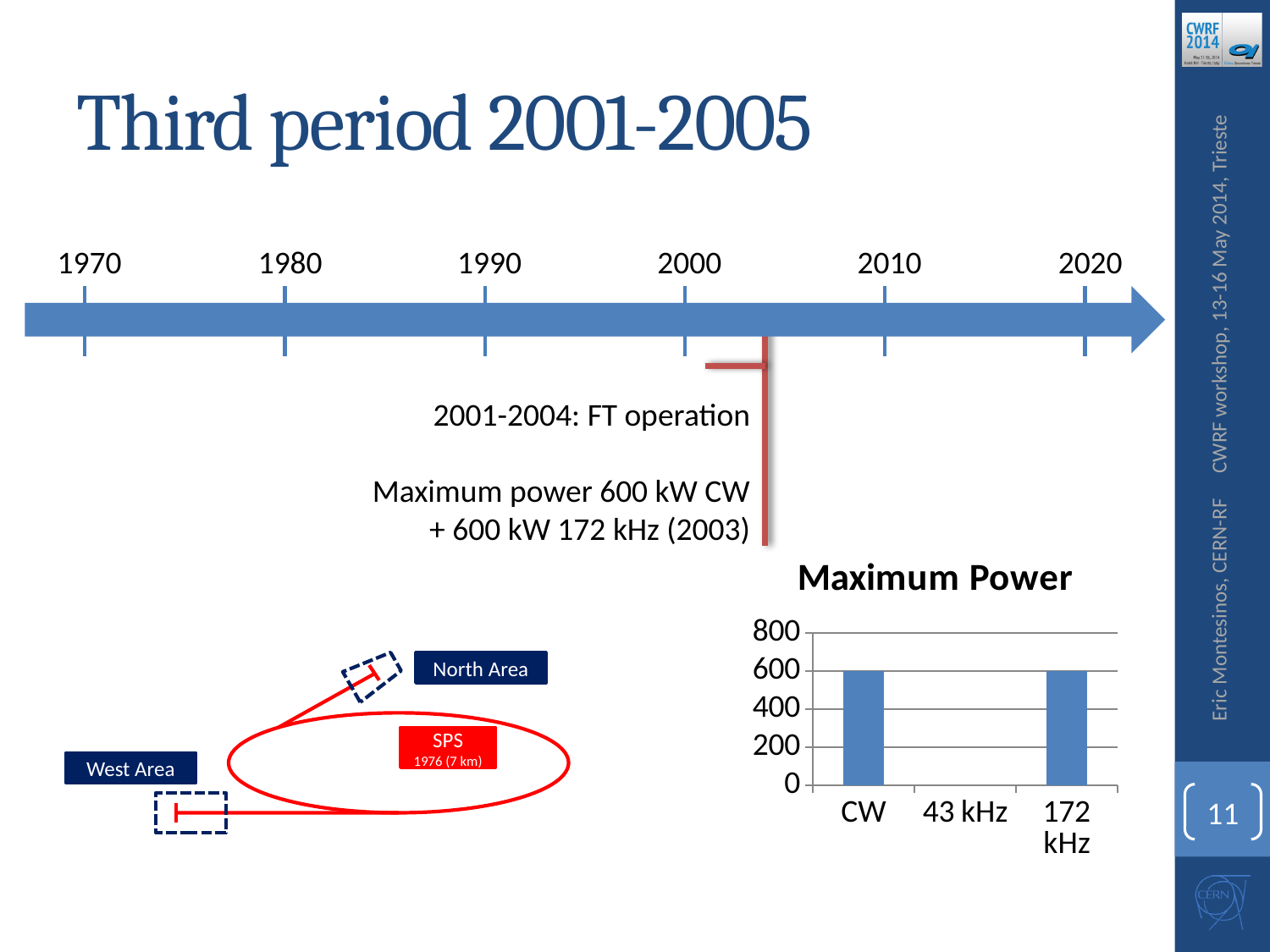
In the Maximum Power chart, what is the difference between the values for CW and 172 kHz? 0 In the Maximum Power chart, what is the value for CW? 600 In the Maximum Power chart, is the value for 43 kHz greater or less than 200? less What is the highest tick value shown on the y axis of the Maximum Power chart? 800 In the Maximum Power chart, which category has the lowest value? 43 kHz In the Maximum Power chart, is the value for CW greater or less than 400? greater How many categories are shown on the x axis of the Maximum Power chart? 3 In the Maximum Power chart, is the value for 172 kHz greater or less than 800? less What is the title of the chart on the slide? Maximum Power In the Maximum Power chart, what is the value for 172 kHz? 600 In the Maximum Power chart, which is larger, the value for CW or the value for 43 kHz? CW What kind of chart is the Maximum Power chart? bar chart